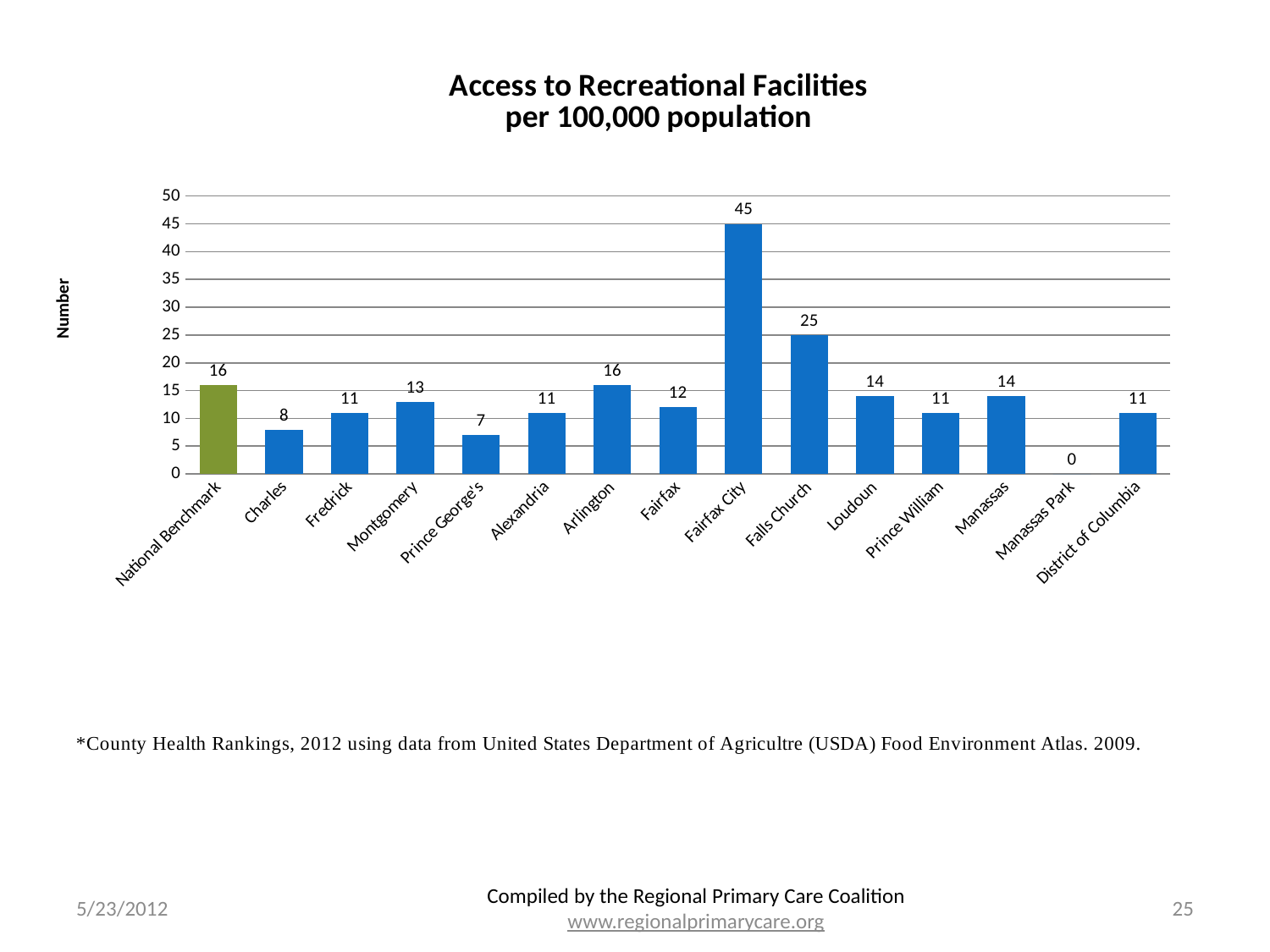
Which is larger, the value for Montgomery or the value for Charles? Montgomery Which category has the lowest value? Manassas Park What is the value for Prince George's? 7 Is the value for Falls Church greater or less than 20? greater How many categories are shown on the x axis? 15 What is the difference between the values for Fairfax City and Falls Church? 20 Which category has the highest value? Fairfax City What kind of chart is shown on the slide? bar chart What is the title of the chart? Access to Recreational Facilities per 100,000 population What is the value for Fairfax City? 45 What is the value for Manassas Park? 0 What is the value for the National Benchmark? 16